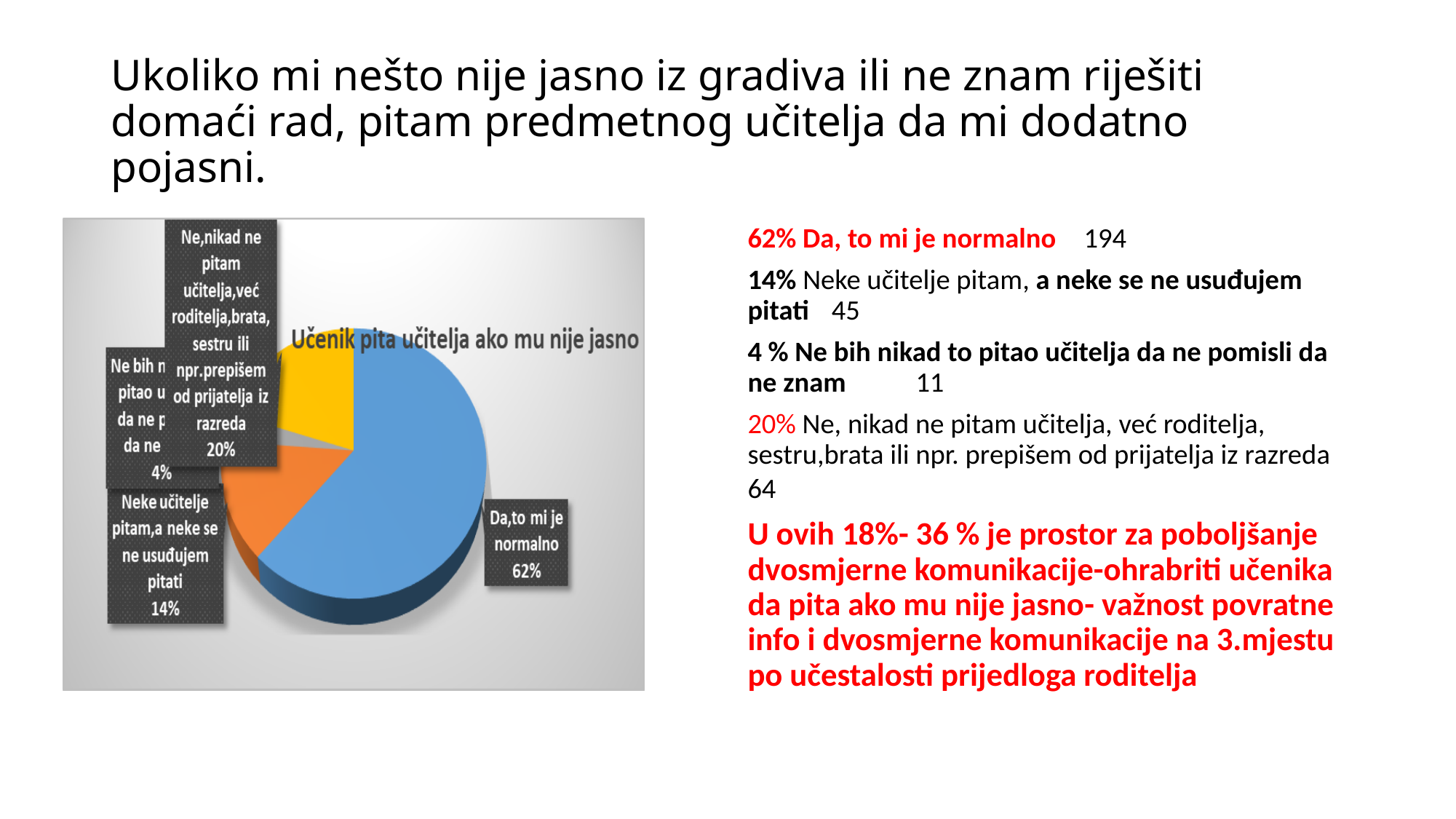
What percentage of the pie is labelled "Ne, nikad ne pitam učitelja, već roditelja, brata, sestru ili npr. prepišem od prijatelja iz razreda"? 20% What kind of chart is shown on the slide? pie chart What is the title of the pie chart? Učenik pita učitelja ako mu nije jasno What colour is the "Da, to mi je normalno" slice in the pie chart? blue What percentage of the pie is labelled "Da, to mi je normalno"? 62% What percentage of the pie is labelled "Neke učitelje pitam, a neke se ne usuđujem pitati"? 14% What is the difference in percentage points between the "Da, to mi je normalno" slice and the "Ne, nikad ne pitam učitelja" slice? 42 What is the combined percentage of the 14% and 20% slices? 34% Which slice of the pie chart is the smallest? the 4% slice (Ne bih nikad to pitao učitelja da ne pomisli da ne znam) Which is larger: the "Neke učitelje pitam, a neke se ne usuđujem pitati" slice or the "Ne, nikad ne pitam učitelja" slice? Ne, nikad ne pitam učitelja How many slices does the pie chart have? 4 Which slice of the pie chart is the largest? Da, to mi je normalno